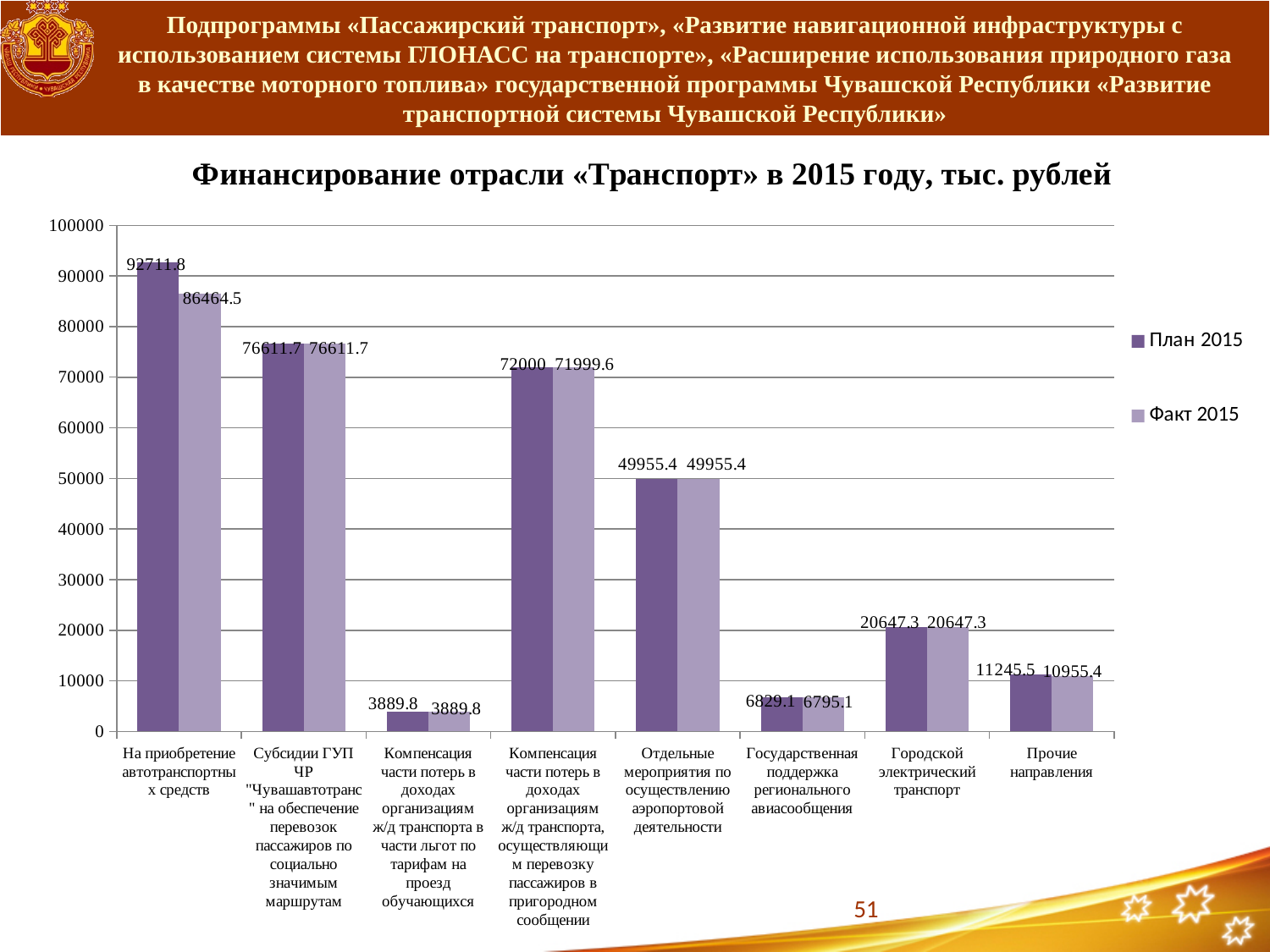
What is the План 2015 value for «На приобретение автотранспортных средств»? 92711.8 Which is larger: the Факт 2015 value for «Отдельные мероприятия по осуществлению аэропортовой деятельности» or for «Городской электрический транспорт»? Отдельные мероприятия по осуществлению аэропортовой деятельности What is the Факт 2015 value for «На приобретение автотранспортных средств»? 86464.5 What type of chart is shown on the slide? Bar chart What is the Факт 2015 value for «Государственная поддержка регионального авиасообщения»? 6795.1 Which category has the lowest Факт 2015 value? Компенсация части потерь в доходах организациям ж/д транспорта в части льгот по тарифам на проезд обучающихся How many categories are shown on the x axis of the chart? 8 What is the План 2015 value for «Городской электрический транспорт»? 20647.3 What is the difference between the План 2015 and Факт 2015 values for «На приобретение автотранспортных средств»? 6247.3 What is the difference between the План 2015 and Факт 2015 values for «Прочие направления»? 290.1 Which category has the highest План 2015 value? На приобретение автотранспортных средств How many series does the legend list? 2